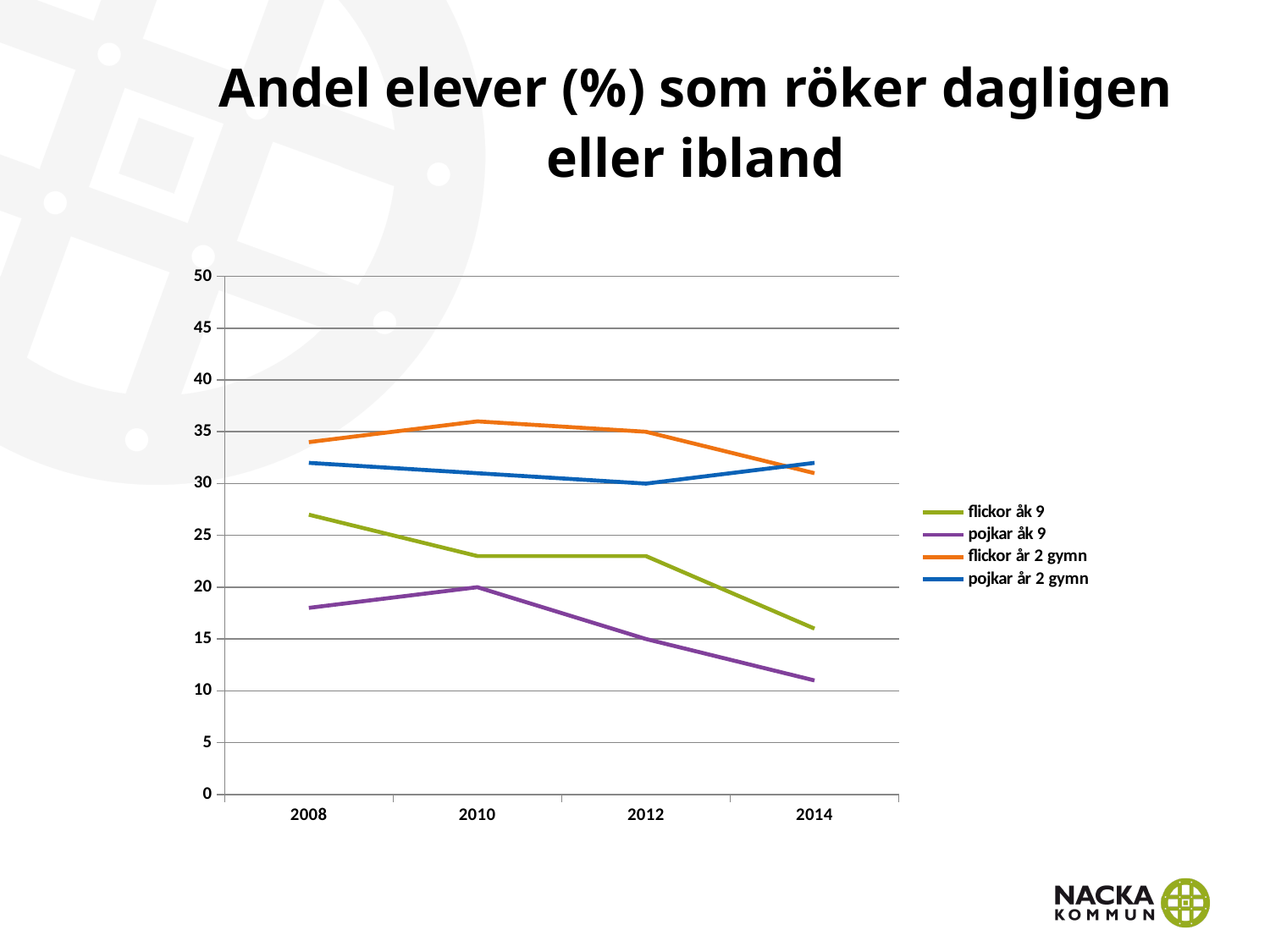
What kind of chart is shown on the slide? line chart Is the value for flickor år 2 gymn in 2010 greater or less than 35? greater What is the title of the chart? Andel elever (%) som röker dagligen eller ibland Which series has the lowest value in 2014? pojkar åk 9 How many years are shown on the x axis? 4 Does the value for flickor åk 9 rise or fall from 2008 to 2014? fall Which series has the highest value in 2010? flickor år 2 gymn Is the value for flickor åk 9 in 2008 greater or less than 25? greater Is the value for pojkar åk 9 in 2014 greater or less than 15? less Which is larger in 2014, the value for flickor åk 9 or the value for pojkar åk 9? flickor åk 9 Does the value for pojkar åk 9 rise or fall from 2010 to 2014? fall How many series does the legend list? 4